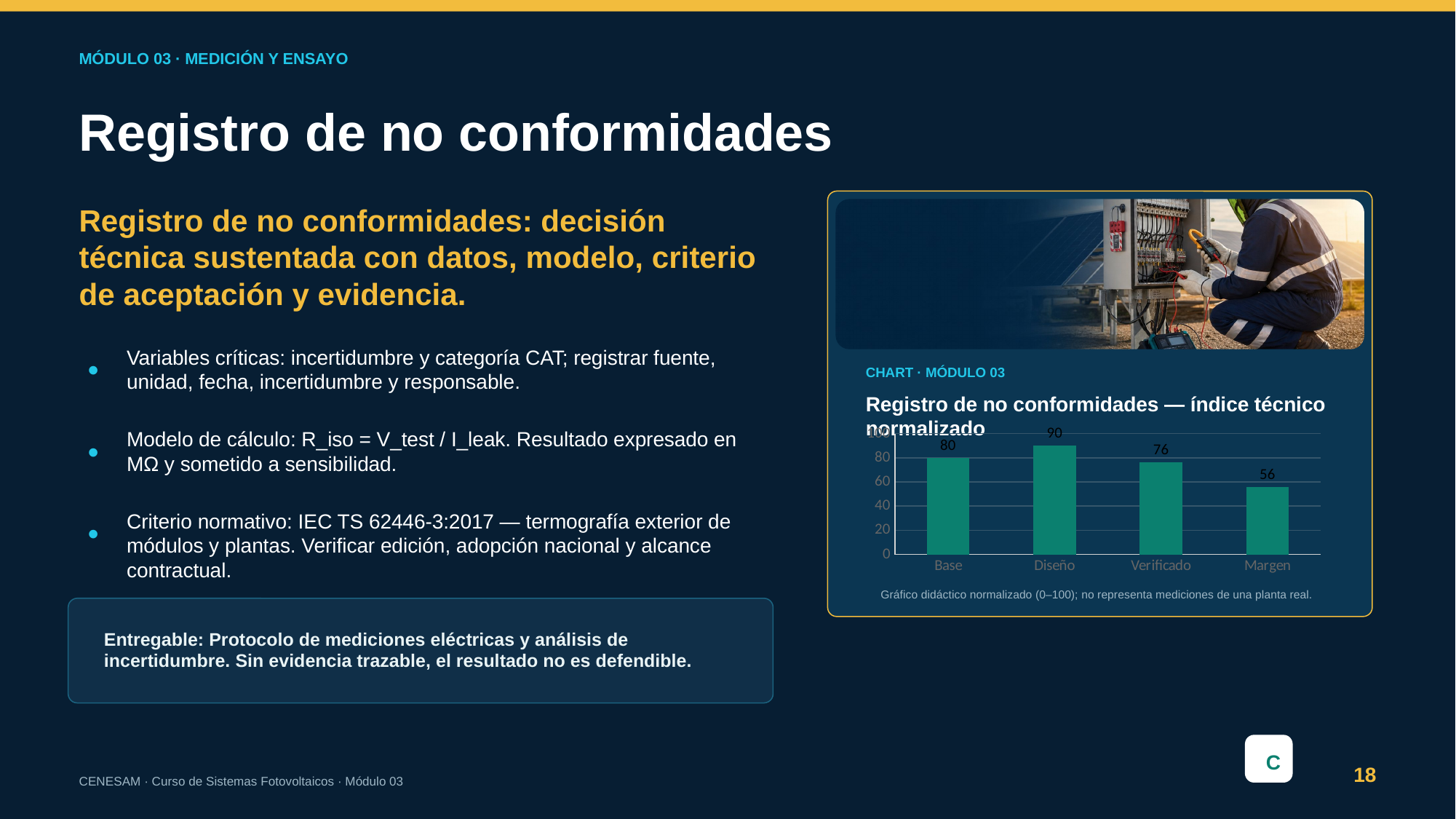
Which is larger, the value for Base or the value for Margen? Base What is the title of the chart? Registro de no conformidades — índice técnico normalizado What is the value for Base? 80 What is the value for Diseño? 90 What is the value for Margen? 56 What is the value for Verificado? 76 How many categories are shown on the x axis? 4 What is the difference between the values for Diseño and Margen? 34 Which category has the lowest value? Margen What is the difference between the values for Base and Verificado? 4 Which category has the highest value? Diseño What kind of chart is shown? Bar chart